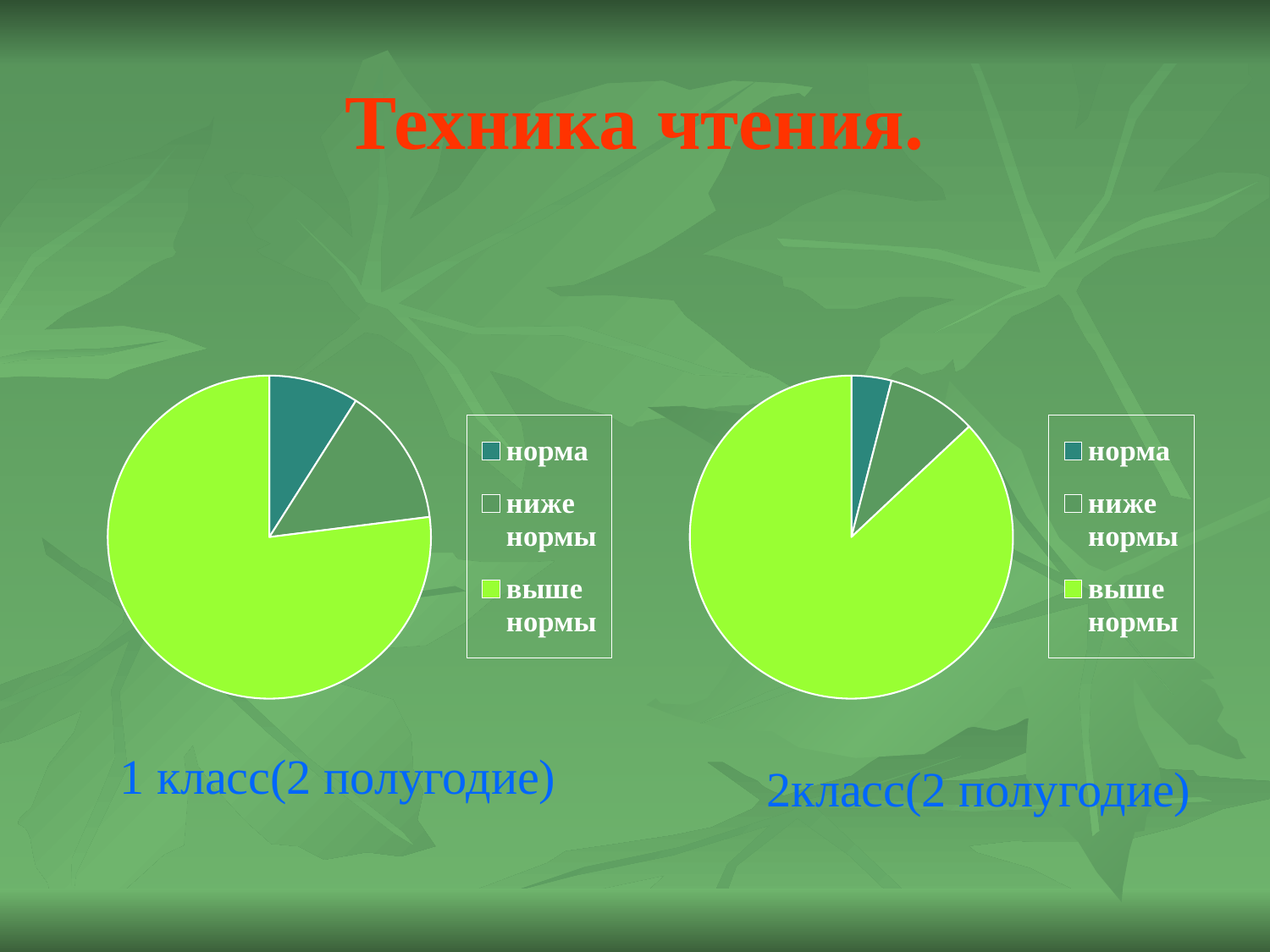
In the "1 класс(2 полугодие)" chart, which category has the smallest slice? норма How many entries does the legend of the "2класс(2 полугодие)" chart list? 3 In the legend of the "1 класс(2 полугодие)" chart, which category is shown in bright light green? выше нормы In the "2класс(2 полугодие)" chart, which category has the largest slice? выше нормы In the "1 класс(2 полугодие)" chart, which slice is larger: "норма" or "ниже нормы"? ниже нормы What is the title of the slide containing the two pie charts? Техника чтения. In the "2класс(2 полугодие)" chart, which category has the smallest slice? норма In the "1 класс(2 полугодие)" chart, which category has the largest slice? выше нормы What kind of chart is used for "1 класс(2 полугодие)"? pie chart What kind of chart is used for "2класс(2 полугодие)"? pie chart How many slices does the "1 класс(2 полугодие)" pie chart have? 3 In the "2класс(2 полугодие)" chart, which slice is larger: "выше нормы" or "ниже нормы"? выше нормы